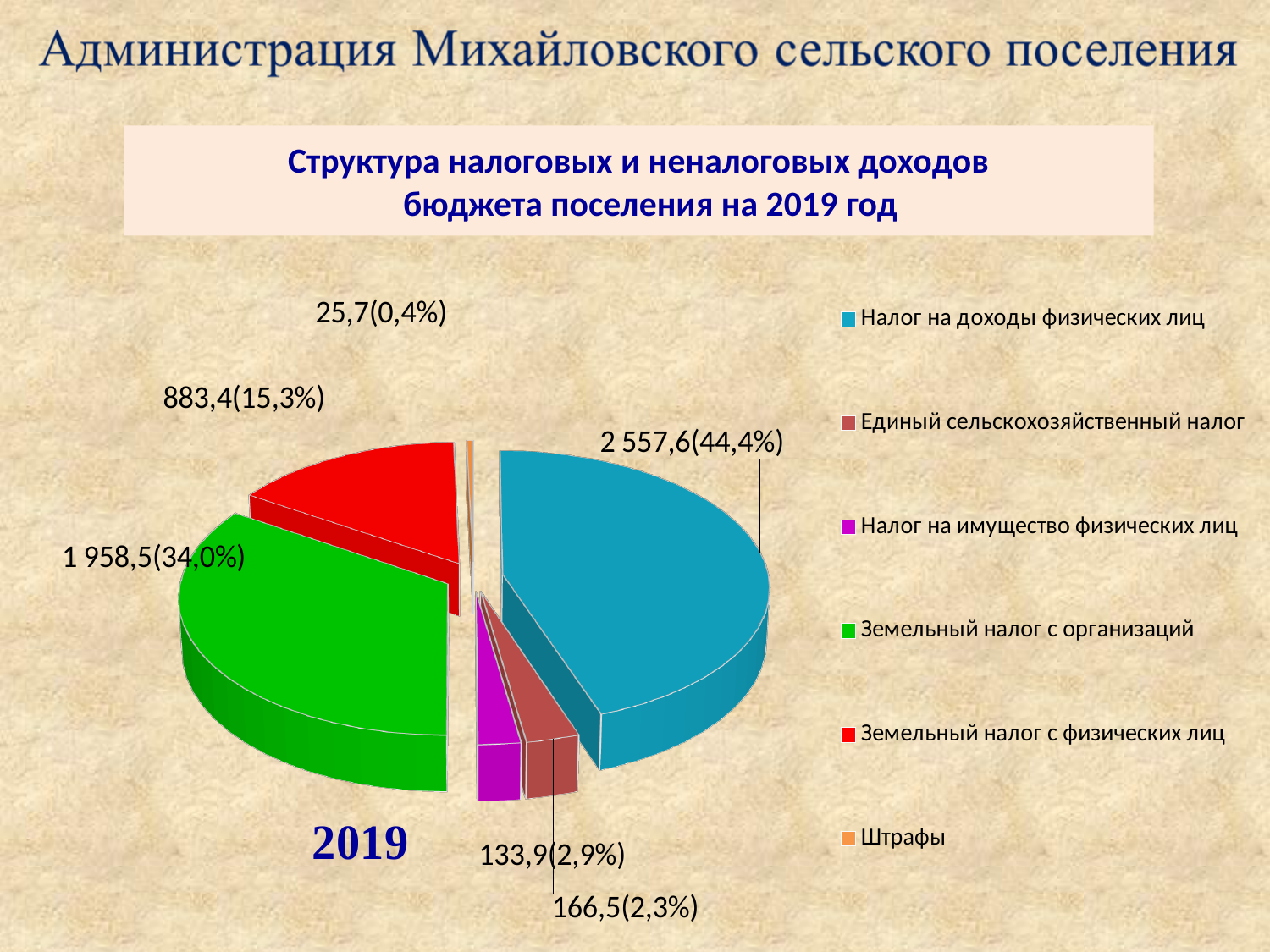
What kind of chart is shown on the slide? pie chart Which is larger, Земельный налог с физических лиц or Земельный налог с организаций? Земельный налог с организаций What value is shown for Налог на доходы физических лиц? 2 557,6(44,4%) Which category has the largest slice of the pie? Налог на доходы физических лиц Which category has the smallest slice of the pie? Штрафы What value is shown for Земельный налог с организаций? 1 958,5(34,0%) How many categories does the legend of the pie chart list? 6 What value is shown for Земельный налог с физических лиц? 883,4(15,3%) What is the difference between the values for Налог на доходы физических лиц and Земельный налог с организаций? 599,1 What year is printed below the pie chart? 2019 What value is shown for Штрафы? 25,7(0,4%) What share of the pie does Земельный налог с организаций take? 34,0%